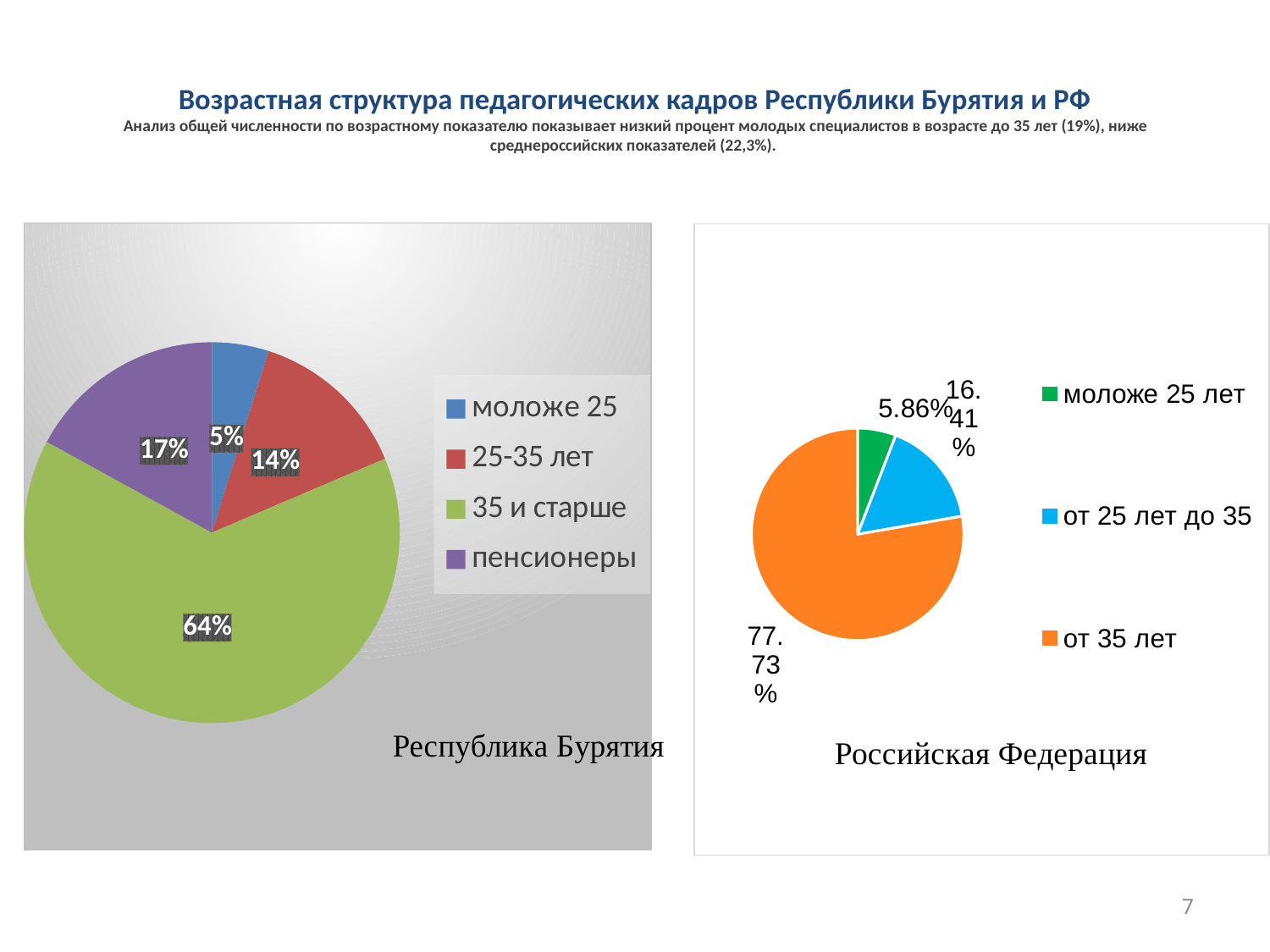
In the Республика Бурятия chart, what is the value for пенсионеры? 17% In the Республика Бурятия chart, what is the difference between пенсионеры and 25-35 лет? 3% In the Республика Бурятия chart, which category has the smallest share? моложе 25 In the Российская Федерация chart, what is the value for моложе 25 лет? 5.86% In the Российская Федерация chart, what is the value for от 35 лет? 77.73% In the Республика Бурятия chart, what is the value for 35 и старше? 64% In the Российская Федерация chart, which is larger: от 25 лет до 35 or моложе 25 лет? от 25 лет до 35 In the Российская Федерация chart, which category has the smallest share? моложе 25 лет What type of chart is the Республика Бурятия chart? pie chart In the Республика Бурятия chart, which category has the largest share? 35 и старше How many categories does the Российская Федерация chart show? 3 In the Республика Бурятия chart, what is the value for моложе 25? 5%